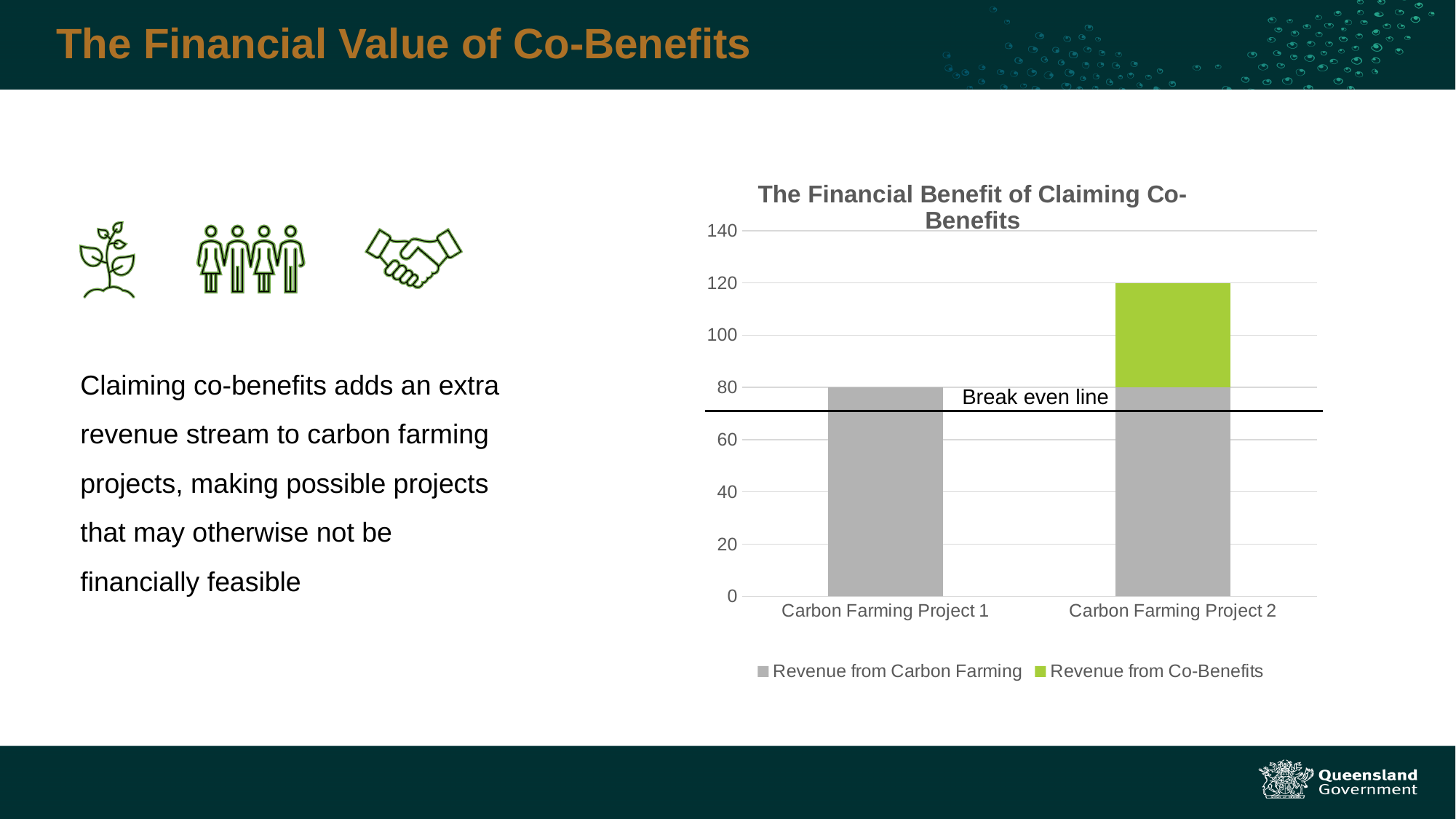
Which project has the lowest total bar? Carbon Farming Project 1 Is the total value for Carbon Farming Project 2 greater or less than 100? greater How many series does the chart legend list? 2 What is the title of the chart? The Financial Benefit of Claiming Co-Benefits Is the Break even line drawn above or below 80 on the y axis? below What kind of chart is shown on the slide? Stacked bar chart Which project has the higher total bar, Carbon Farming Project 1 or Carbon Farming Project 2? Carbon Farming Project 2 What is the Revenue from Carbon Farming for Carbon Farming Project 1? 80 How many categories are shown on the x axis of the chart? 2 What is the difference between the total bar for Carbon Farming Project 2 and the total bar for Carbon Farming Project 1? 40 What is the total height of the stacked bar for Carbon Farming Project 2? 120 What is the Revenue from Co-Benefits for Carbon Farming Project 2? 40